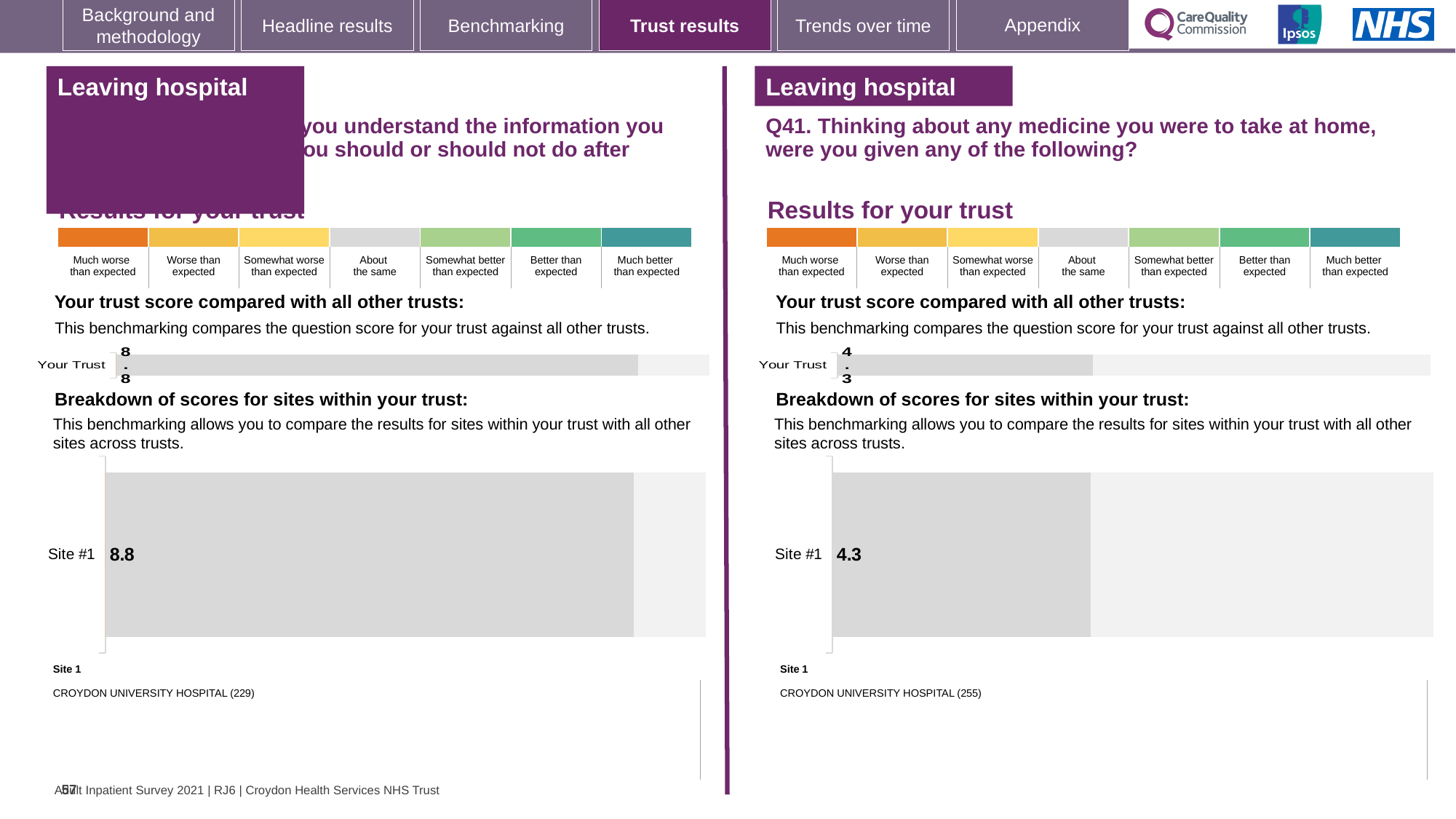
Is the Site #1 score on the left-hand chart equal to the Your Trust score on the same side? Yes, both are 8.8 What is the difference between the Site #1 score on the left-hand chart and the Site #1 score on the right-hand Q41 chart? 4.5 On the left-hand 'Your trust score compared with all other trusts' bar, what value is shown for Your Trust? 8.8 Which is larger: the Site #1 score on the left-hand chart or the Site #1 score on the right-hand Q41 chart? Left-hand chart (8.8) On the right-hand chart for Q41, what is the score shown for Site #1? 4.3 On the left-hand chart, which site is listed as Site 1? CROYDON UNIVERSITY HOSPITAL (229) How many sites are shown in the 'Breakdown of scores for sites within your trust' chart on the right-hand Q41 side? 1 On the left-hand chart, what is the score shown for Site #1? 8.8 What type of chart is used for the 'Breakdown of scores for sites within your trust' on the left-hand side? Bar chart How many sites are shown in the 'Breakdown of scores for sites within your trust' chart on the left-hand side? 1 On the right-hand 'Your trust score compared with all other trusts' bar for Q41, what value is shown for Your Trust? 4.3 On the right-hand Q41 chart, which site is listed as Site 1? CROYDON UNIVERSITY HOSPITAL (255)